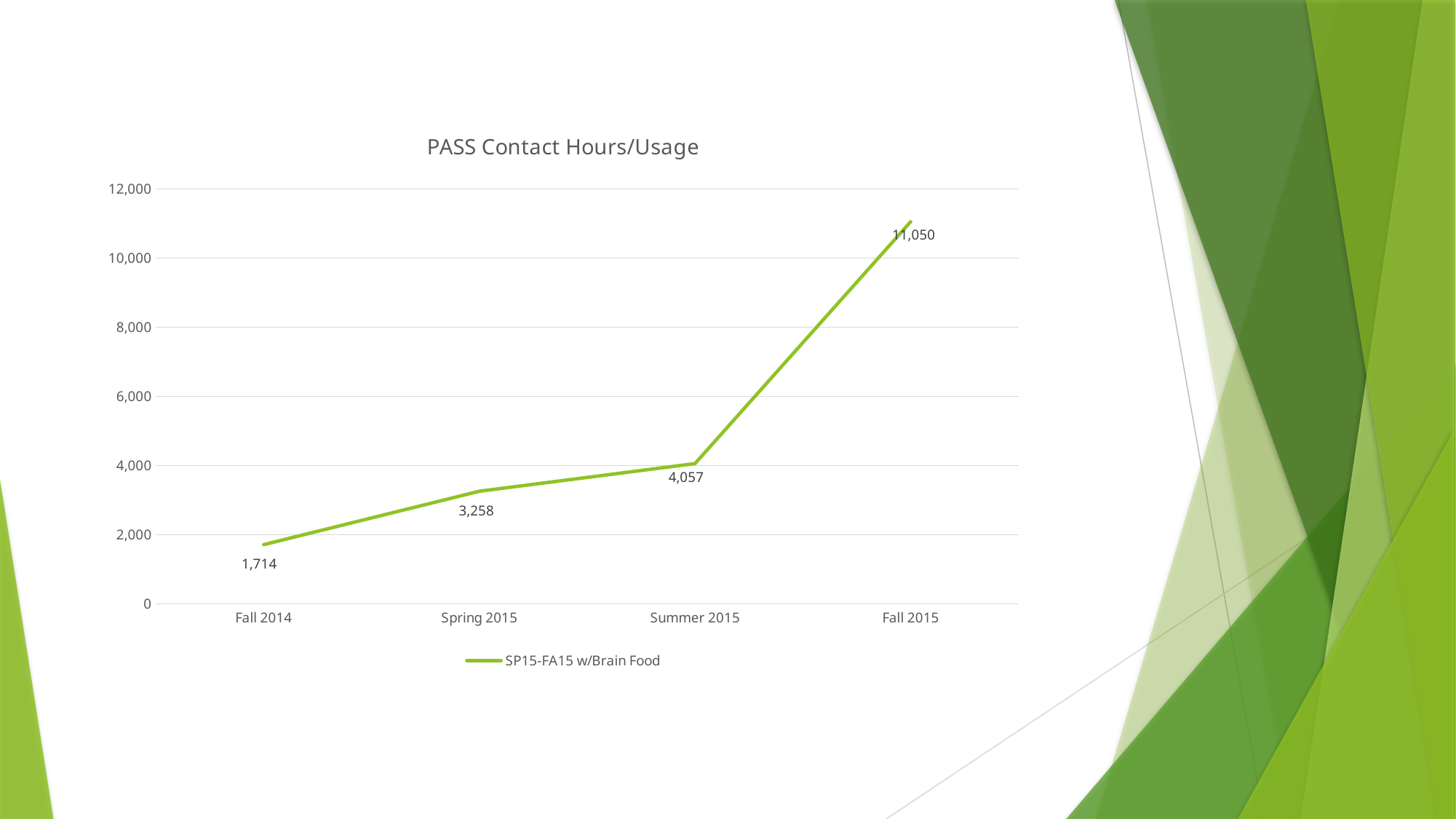
What is the difference between the Fall 2015 and Summer 2015 values? 6,993 Do the values rise or fall from Fall 2014 to Fall 2015? Rise How many periods are plotted on the x axis? 4 What is the value for Fall 2015? 11,050 What kind of chart is shown? Line chart What is the value for Summer 2015? 4,057 What is the value for Spring 2015? 3,258 Which is larger, the value for Summer 2015 or Spring 2015? Summer 2015 Which period has the lowest value? Fall 2014 Which period has the highest value? Fall 2015 What is the value for Fall 2014? 1,714 What is the difference between the Spring 2015 and Fall 2014 values? 1,544